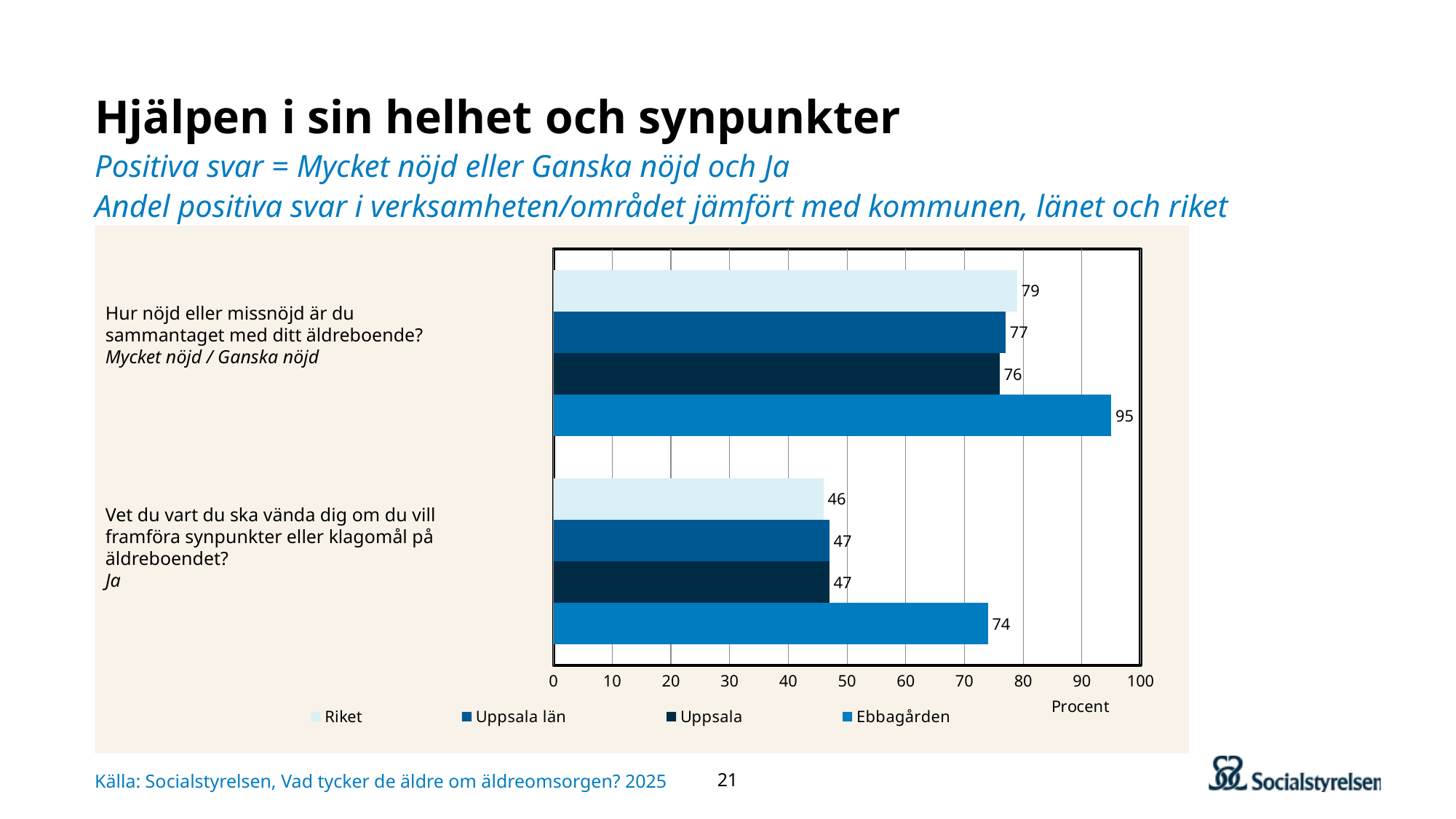
What is the difference between Ebbagården and Riket on the question 'Hur nöjd eller missnöjd är du sammantaget med ditt äldreboende?'? 16 What unit label is shown on the x axis of the chart? Procent How many question categories are shown on the chart? 2 What is the difference between Ebbagården and Uppsala on the question 'Vet du vart du ska vända dig om du vill framföra synpunkter eller klagomål på äldreboendet?'? 27 Which series has the lowest value on the question 'Vet du vart du ska vända dig om du vill framföra synpunkter eller klagomål på äldreboendet?'? Riket Which series has the highest value on the question 'Vet du vart du ska vända dig om du vill framföra synpunkter eller klagomål på äldreboendet?'? Ebbagården How many series does the legend list? 4 What is the value for Uppsala on the question 'Hur nöjd eller missnöjd är du sammantaget med ditt äldreboende?'? 76 What is the value for Riket on the question 'Vet du vart du ska vända dig om du vill framföra synpunkter eller klagomål på äldreboendet?'? 46 Which is larger on the question 'Hur nöjd eller missnöjd är du sammantaget med ditt äldreboende?': Ebbagården or Uppsala län? Ebbagården What is the value for Ebbagården on the question 'Hur nöjd eller missnöjd är du sammantaget med ditt äldreboende?'? 95 What kind of chart is shown on the slide? bar chart